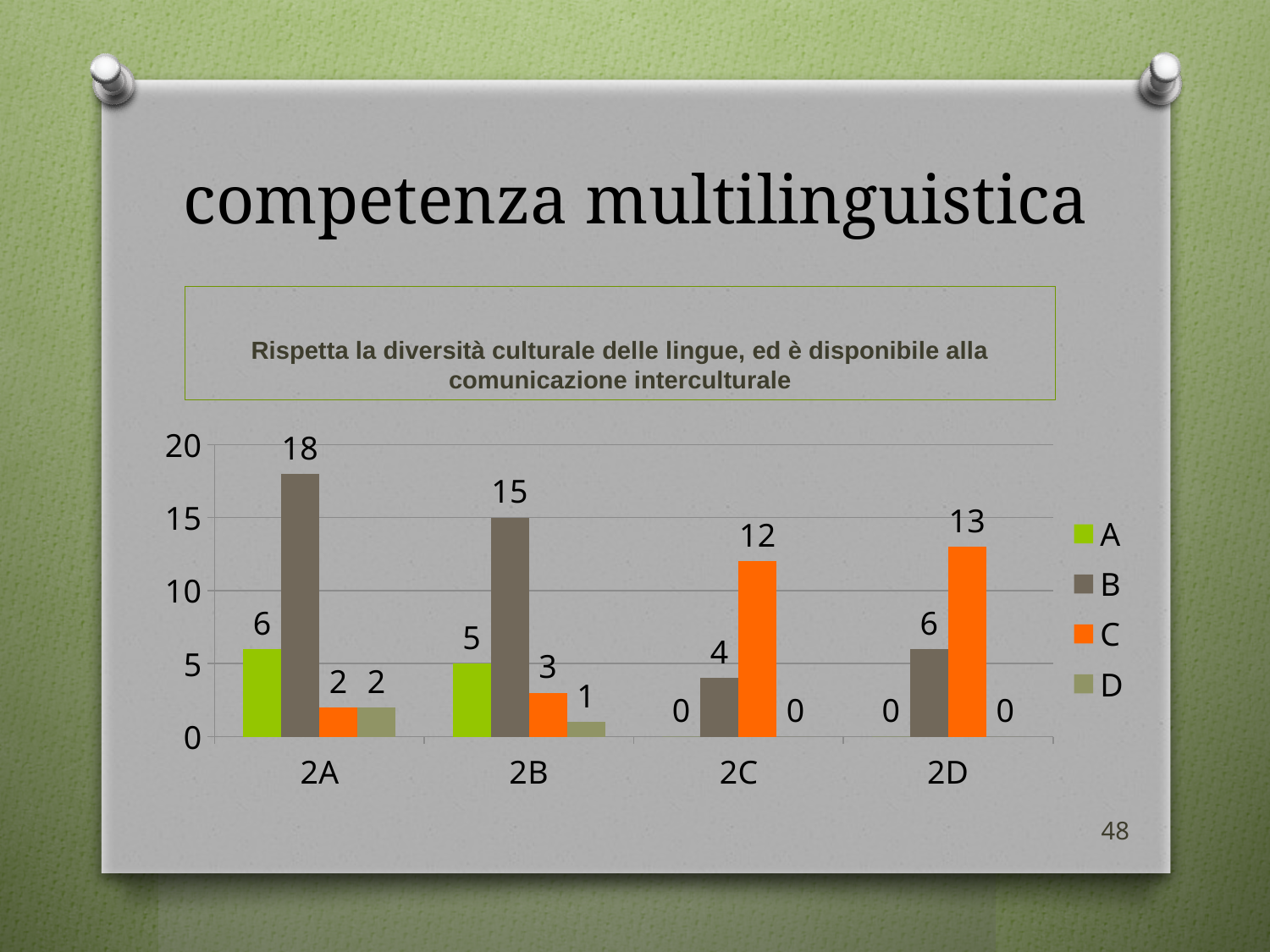
What is the value of series B for category 2A? 18 Which category has the highest value for series B? 2A How many categories are shown on the x axis? 4 Which category has the lowest value for series C? 2A What is the value of series C for category 2D? 13 What colour represents series C in the legend? orange What kind of chart is shown on the slide? bar chart What is the difference between the series B value for 2A and the series B value for 2B? 3 How many series does the legend list? 4 What is the value of series D for category 2B? 1 What is the value of series A for category 2B? 5 Which is larger: the series C value for 2C or the series C value for 2D? 2D